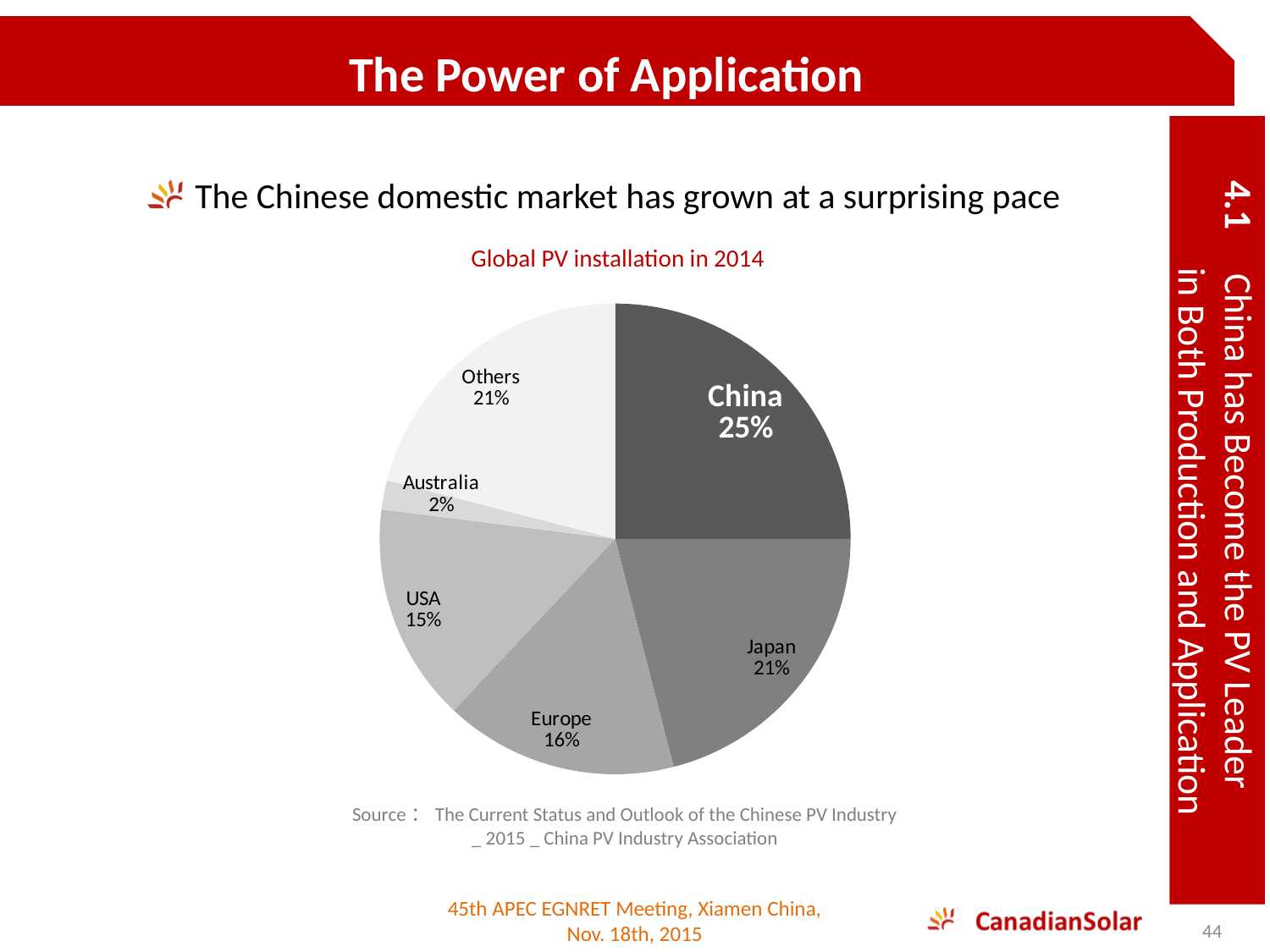
What is the value shown for Japan in the pie chart? 21% What is the value for the USA slice? 15% What is the difference between China's share and the USA's share? 10% What share does Australia have in the pie chart? 2% How many slices does the pie chart have? 6 What percentage is shown for Europe? 16% What share of global PV installation in 2014 does China hold? 25% Which is larger, the share for Europe or the share for USA? Europe Which category has the largest slice of the pie? China What is the title of the chart? Global PV installation in 2014 Which category has the smallest slice of the pie? Australia What kind of chart is shown on the slide? Pie chart